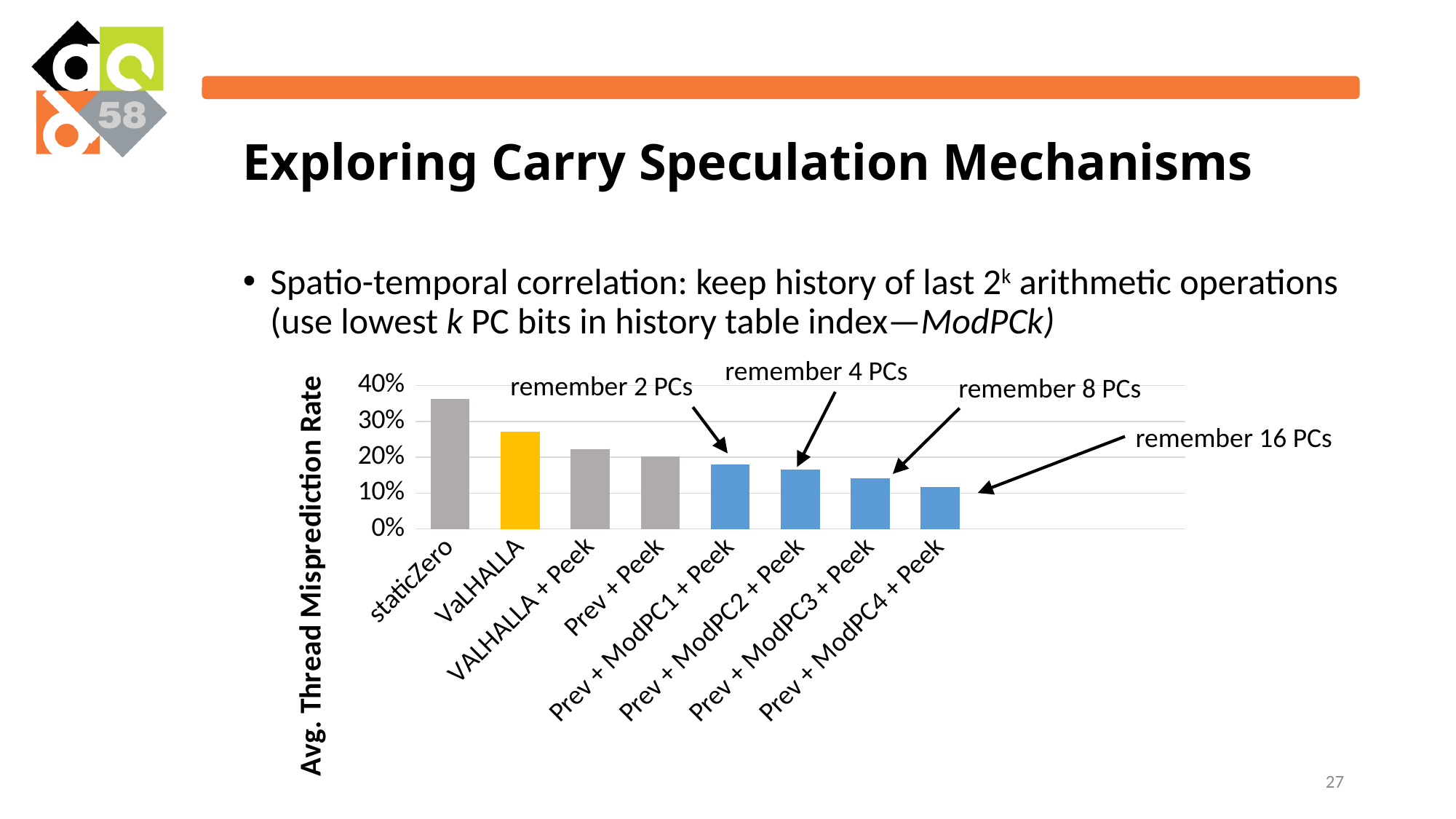
Which category has the highest average thread misprediction rate? staticZero Is the value for Prev + ModPC3 + Peek greater or less than 10%? greater Is the value for Prev + ModPC4 + Peek greater or less than 20%? less Is the value for staticZero greater or less than 30%? greater What is the label on the vertical axis of the chart? Avg. Thread Misprediction Rate What kind of chart is shown on the slide? bar chart Do the misprediction rates rise or fall moving from left to right along the x axis? fall Which category has the lowest average thread misprediction rate? Prev + ModPC4 + Peek Which has a higher misprediction rate, staticZero or VaLHALLA? staticZero How many bars (categories) are plotted in the chart? 8